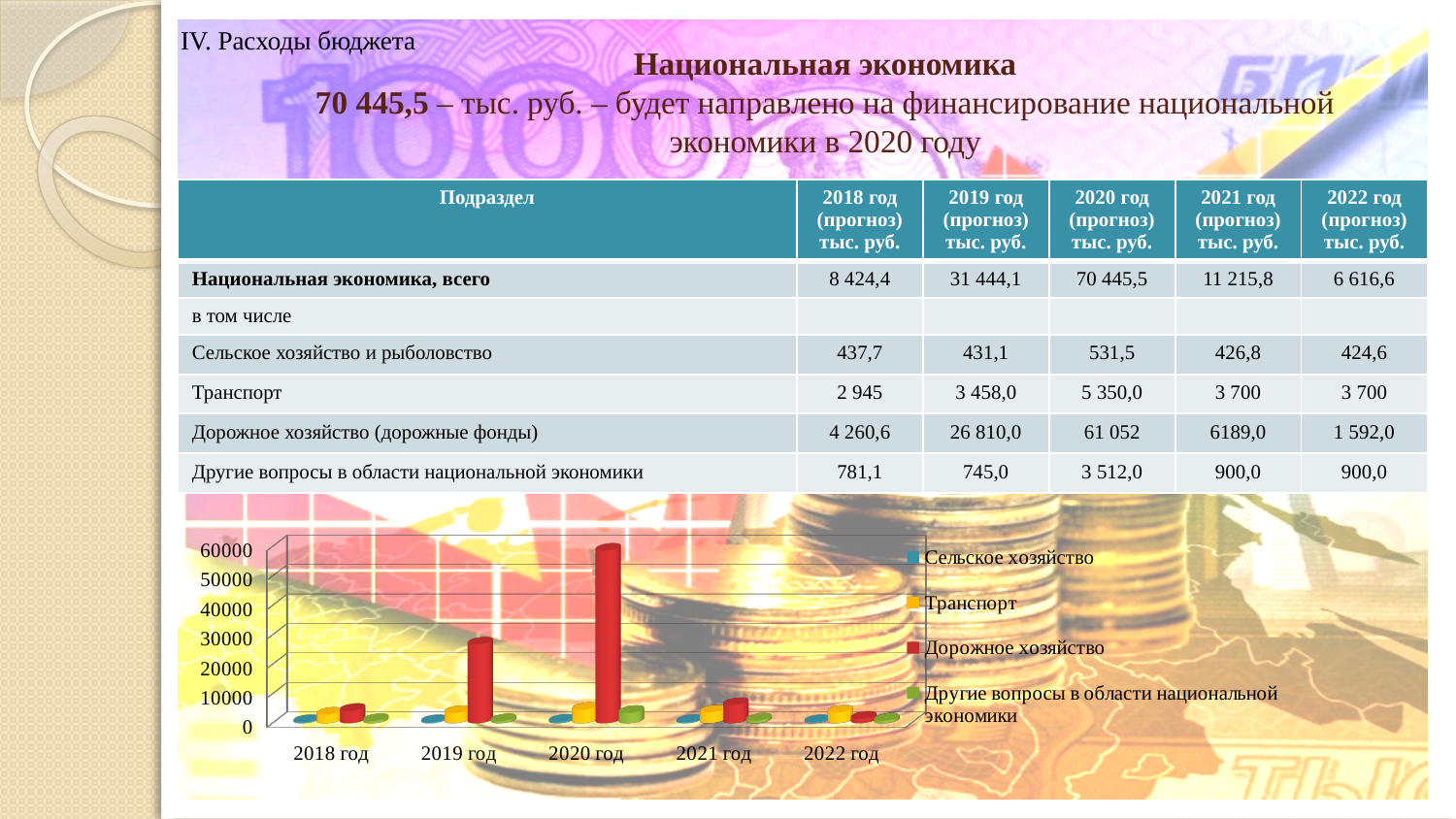
Is the value for Дорожное хозяйство in 2020 год greater or less than 50000? greater How many year categories are shown on the x axis of the chart? 5 Which is larger: the Дорожное хозяйство bar for 2019 год or for 2020 год? 2020 год How does the Дорожное хозяйство series change from 2018 год to 2020 год? rises Is the value for Дорожное хозяйство in 2018 год greater or less than 10000? less Which is larger: the Дорожное хозяйство bar for 2019 год or for 2021 год? 2019 год Is the value for Дорожное хозяйство in 2019 год greater or less than 30000? less What kind of chart is shown at the bottom of the slide? bar chart How many series does the chart legend list? 4 In which year is the bar for Дорожное хозяйство the tallest? 2020 год Which colour represents Дорожное хозяйство in the chart legend? red